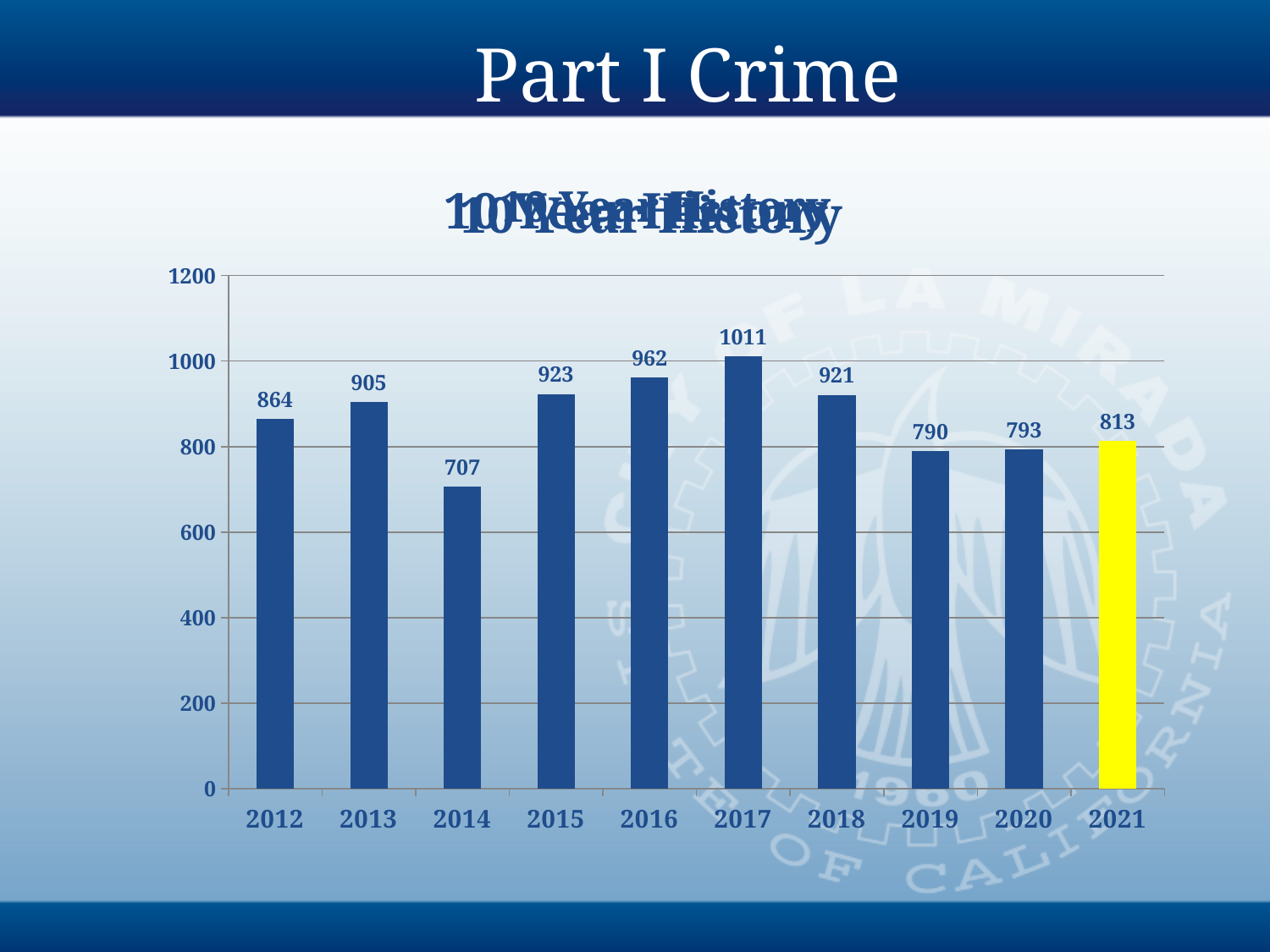
Is the value for 2019 greater or less than 800? less What kind of chart is shown on the slide? bar chart Which year has the lowest value? 2014 What is the value for 2021? 813 Which is larger, the value for 2016 or the value for 2018? 2016 What is the value for 2017? 1011 What is the difference between the values for 2021 and 2020? 20 Which year has the highest value? 2017 What is the difference between the values for 2017 and 2014? 304 What is the value for 2014? 707 How many years are shown on the x axis? 10 Which bar is coloured yellow instead of blue? 2021